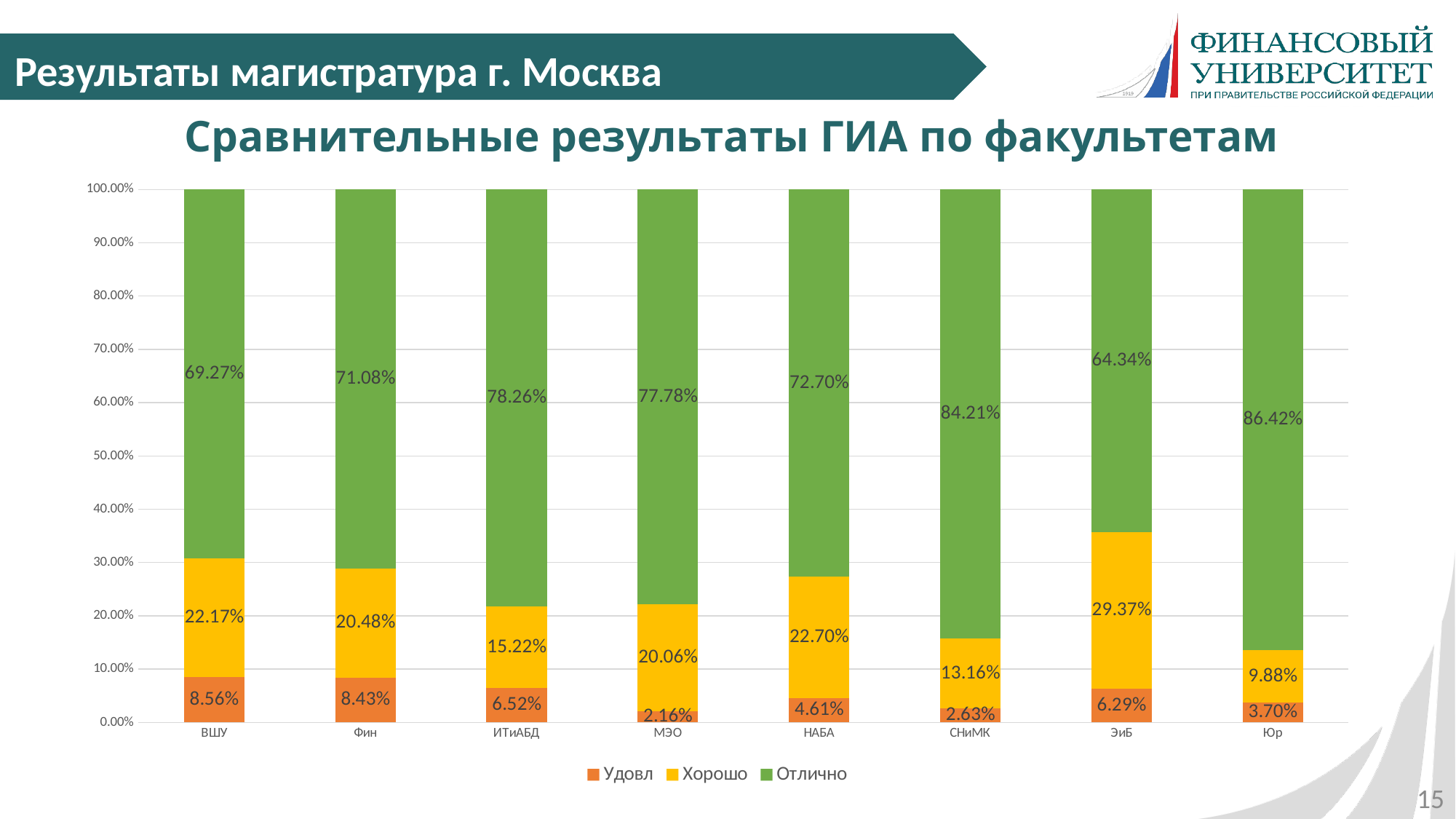
What is the value of Хорошо for ЭиБ? 29.37% What kind of chart is shown on the slide? Stacked bar chart What is the value of Удовл for МЭО? 2.16% How many series does the legend list? 3 How many faculties are shown on the x axis? 8 Which faculty has the highest Отлично share? Юр Which is larger, the Удовл value for ИТиАБД or for ЭиБ? ИТиАБД What is the value of Отлично for Юр? 86.42% Which faculty has the highest Хорошо share? ЭиБ What is the difference between the Отлично values for Юр and ЭиБ? 22.08% Which faculty has the lowest Отлично share? ЭиБ What is the total of the stacked bar for ВШУ? 100.00%